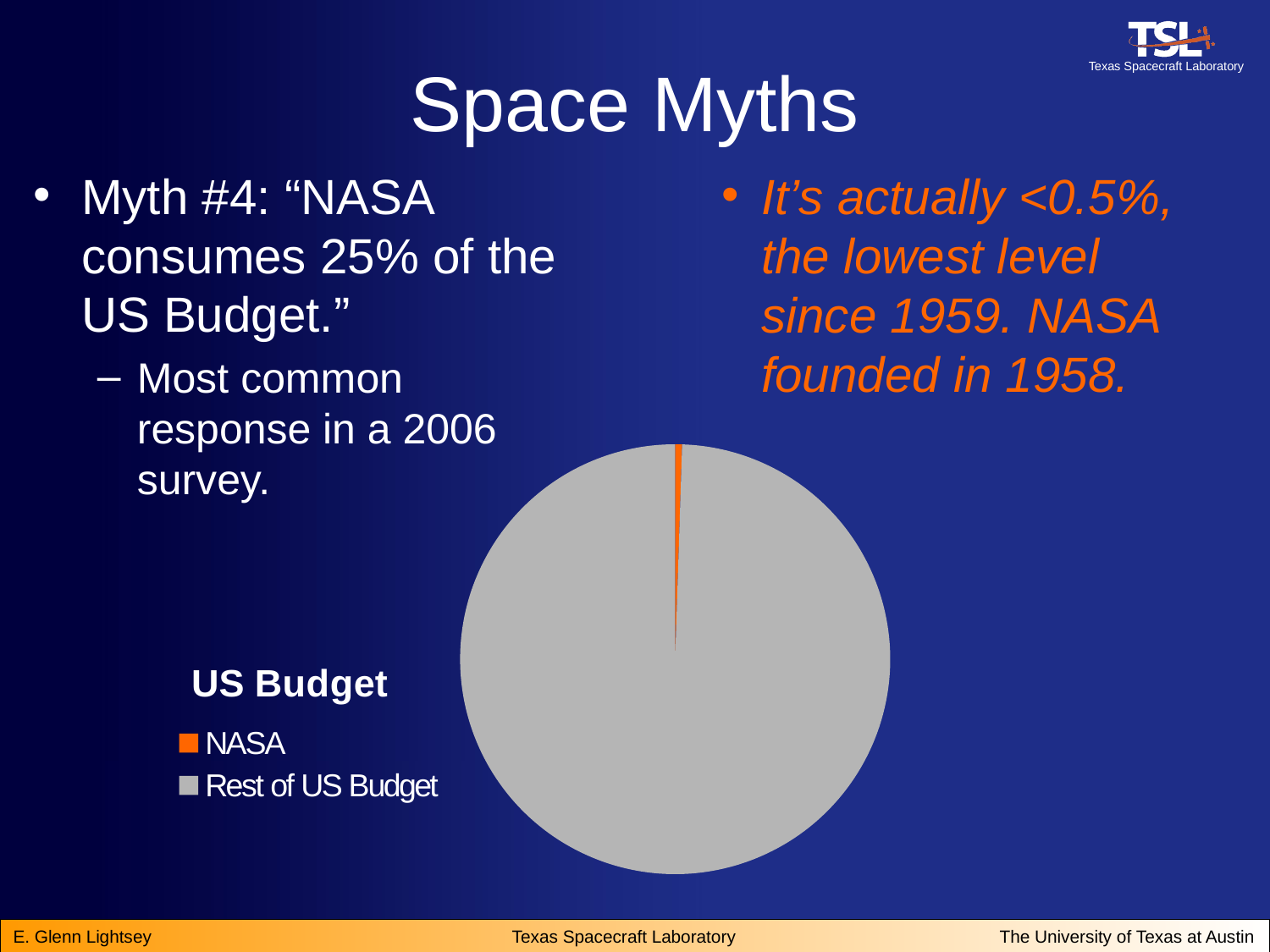
What kind of chart is shown on the slide? pie chart Which slice of the pie chart is the largest? Rest of US Budget In the pie chart, which is larger: the NASA slice or the Rest of US Budget slice? Rest of US Budget Which legend entry in the pie chart is shown in gray? Rest of US Budget Which slice of the pie chart is the smallest? NASA How many slices does the pie chart have? 2 How many entries does the pie chart's legend list? 2 What is the title of the pie chart? US Budget What colour is the NASA slice in the pie chart? orange